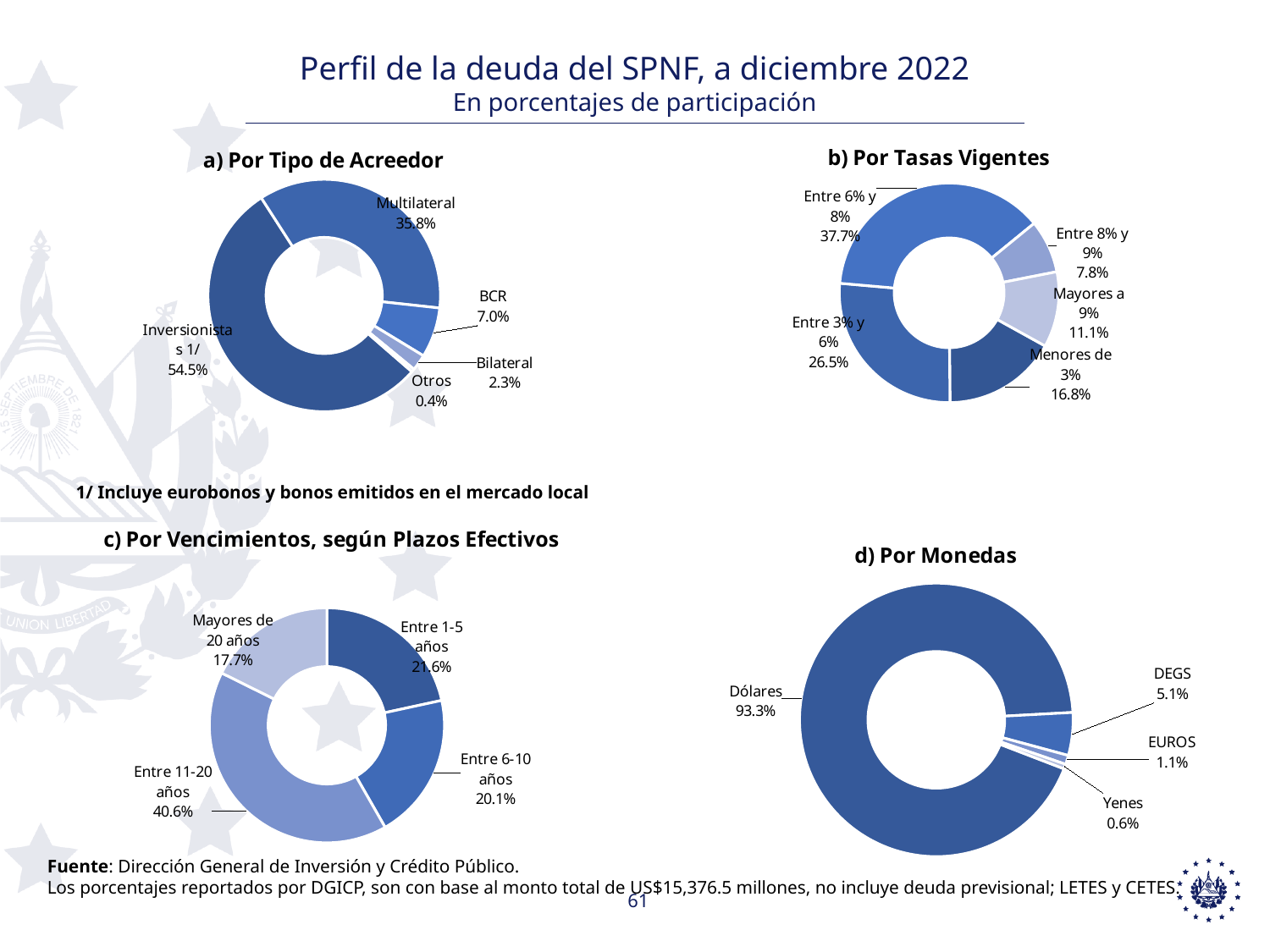
In the chart 'b) Por Tasas Vigentes', how many categories are shown? 5 In the chart 'c) Por Vencimientos, según Plazos Efectivos', what share corresponds to 'Entre 11-20 años'? 40.6% In the chart 'a) Por Tipo de Acreedor', what share does Multilateral have? 35.8% In the chart 'd) Por Monedas', what share do Dólares have? 93.3% In the chart 'd) Por Monedas', which currency has the smallest share? Yenes In the chart 'b) Por Tasas Vigentes', which category has the largest share? Entre 6% y 8% In the chart 'c) Por Vencimientos, según Plazos Efectivos', what is the difference between 'Entre 1-5 años' and 'Entre 6-10 años'? 1.5% In the chart 'a) Por Tipo de Acreedor', which category has the smallest share? Otros In the chart 'c) Por Vencimientos, según Plazos Efectivos', which is larger: 'Mayores de 20 años' or 'Entre 6-10 años'? Entre 6-10 años In the chart 'b) Por Tasas Vigentes', what share corresponds to 'Entre 3% y 6%'? 26.5% What type of chart is 'd) Por Monedas'? Donut (pie) chart In the chart 'a) Por Tipo de Acreedor', which category has the largest share? Inversionistas 1/